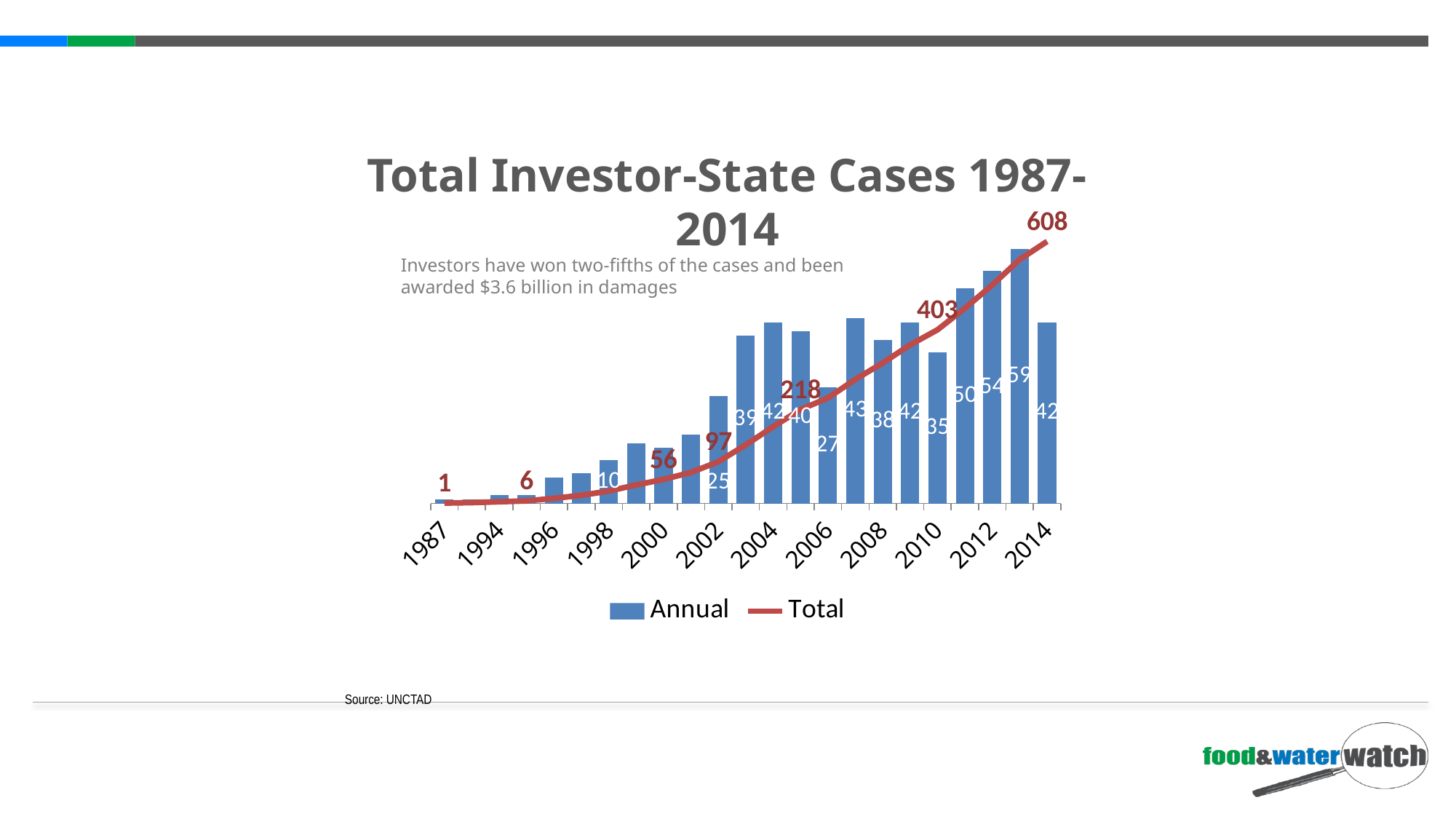
Which year has the highest Annual value? 2013 What is the Annual value for 2013? 59 What is the Annual value for 2006? 27 What kind of chart is shown on the slide? bar and line chart By how much did the Total increase from 2010 to 2014? 205 What is the Total value for 2010? 403 What are the two entries in the legend? Annual and Total What is the Total value for 2014? 608 How many series does the legend list? 2 Does the Total line rise or fall from 1987 to 2014? rise Which year has the larger Annual value, 2011 or 2012? 2012